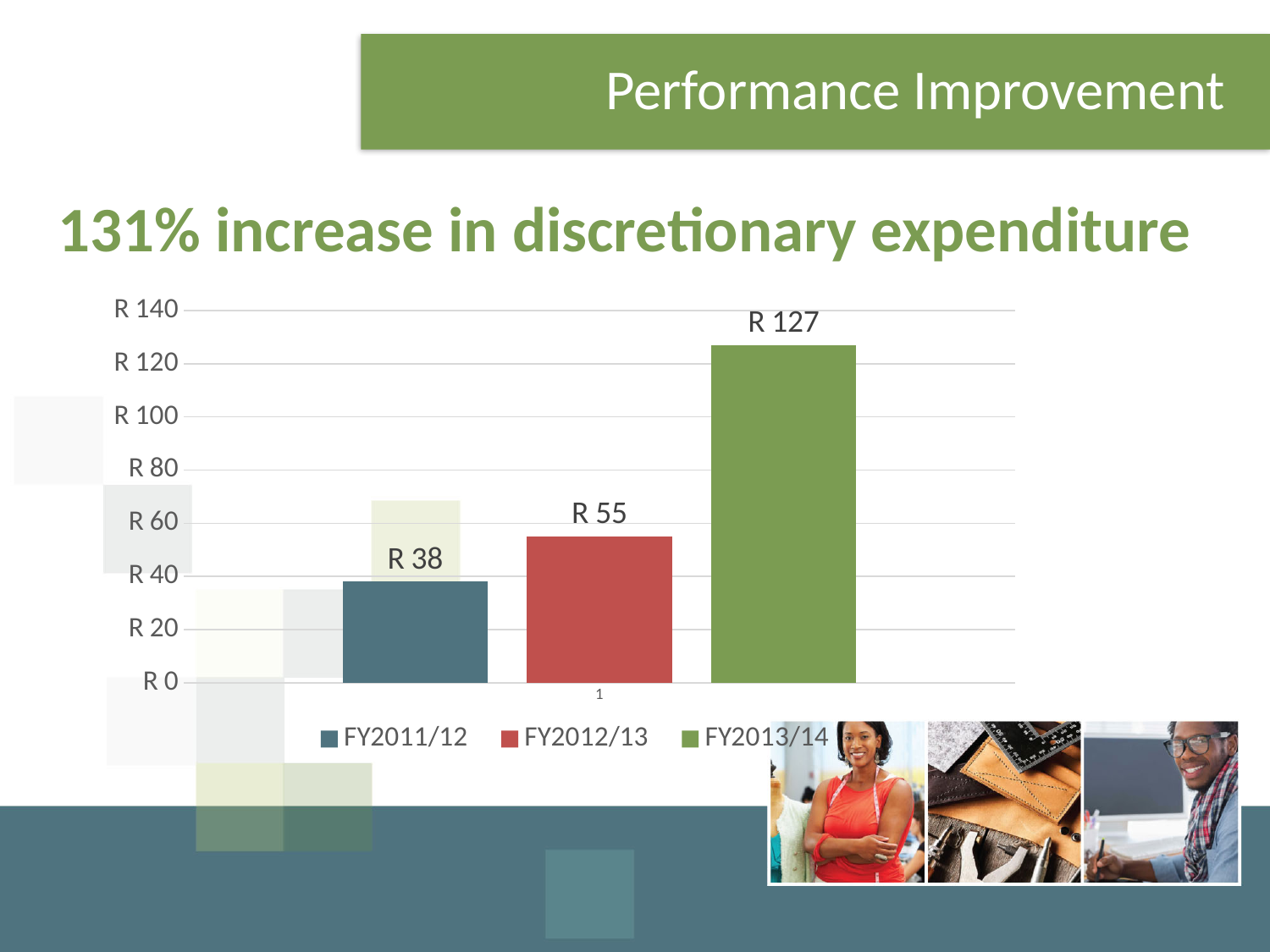
Which is larger, the value for FY2012/13 or FY2011/12? FY2012/13 What is the difference between the FY2013/14 and FY2012/13 values? R 72 What is the value for FY2013/14? R 127 Which series has the lowest value? FY2011/12 What is the difference between the FY2012/13 and FY2011/12 values? R 17 Do the values rise or fall from FY2011/12 to FY2013/14? rise What is the value for FY2012/13? R 55 What is the value for FY2011/12? R 38 How many series does the legend list? 3 Is the value for FY2013/14 greater or less than R 120? greater Which series has the highest value? FY2013/14 What kind of chart is shown on the slide? bar chart